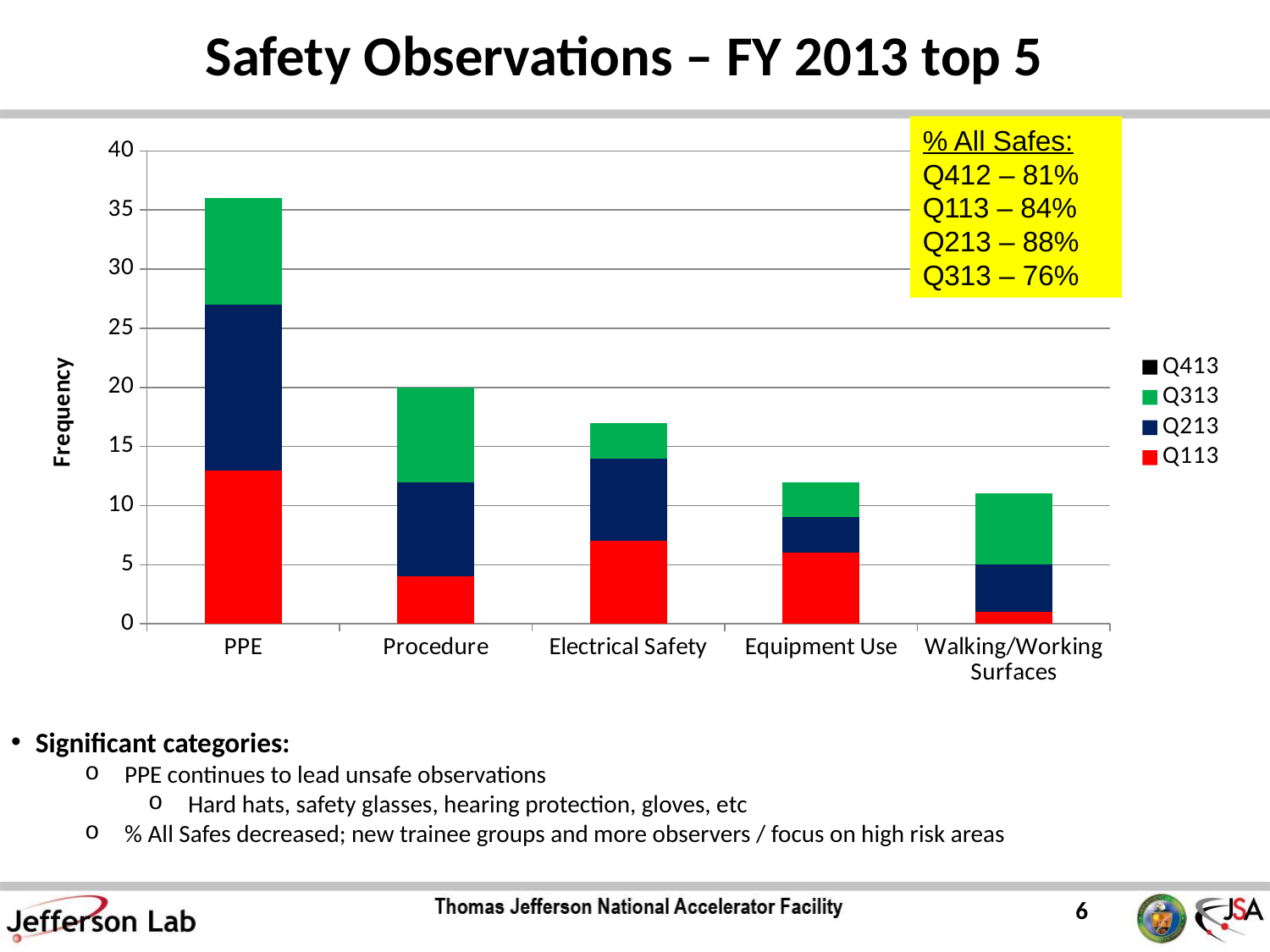
What kind of chart is shown on the slide? Stacked bar chart Which category has the highest total frequency? PPE Do the total frequencies rise or fall moving from left to right across the categories? fall What is the label on the vertical axis of the chart? Frequency How many categories are shown on the x axis of the chart? 5 Is the total frequency for PPE greater or less than 30? greater Is the Q113 value for PPE greater or less than 10? greater Is the total frequency for Equipment Use greater or less than 10? greater Which has a larger total frequency, Electrical Safety or Equipment Use? Electrical Safety How many series does the chart's legend list? 4 Which series is shown in red in the chart's legend? Q113